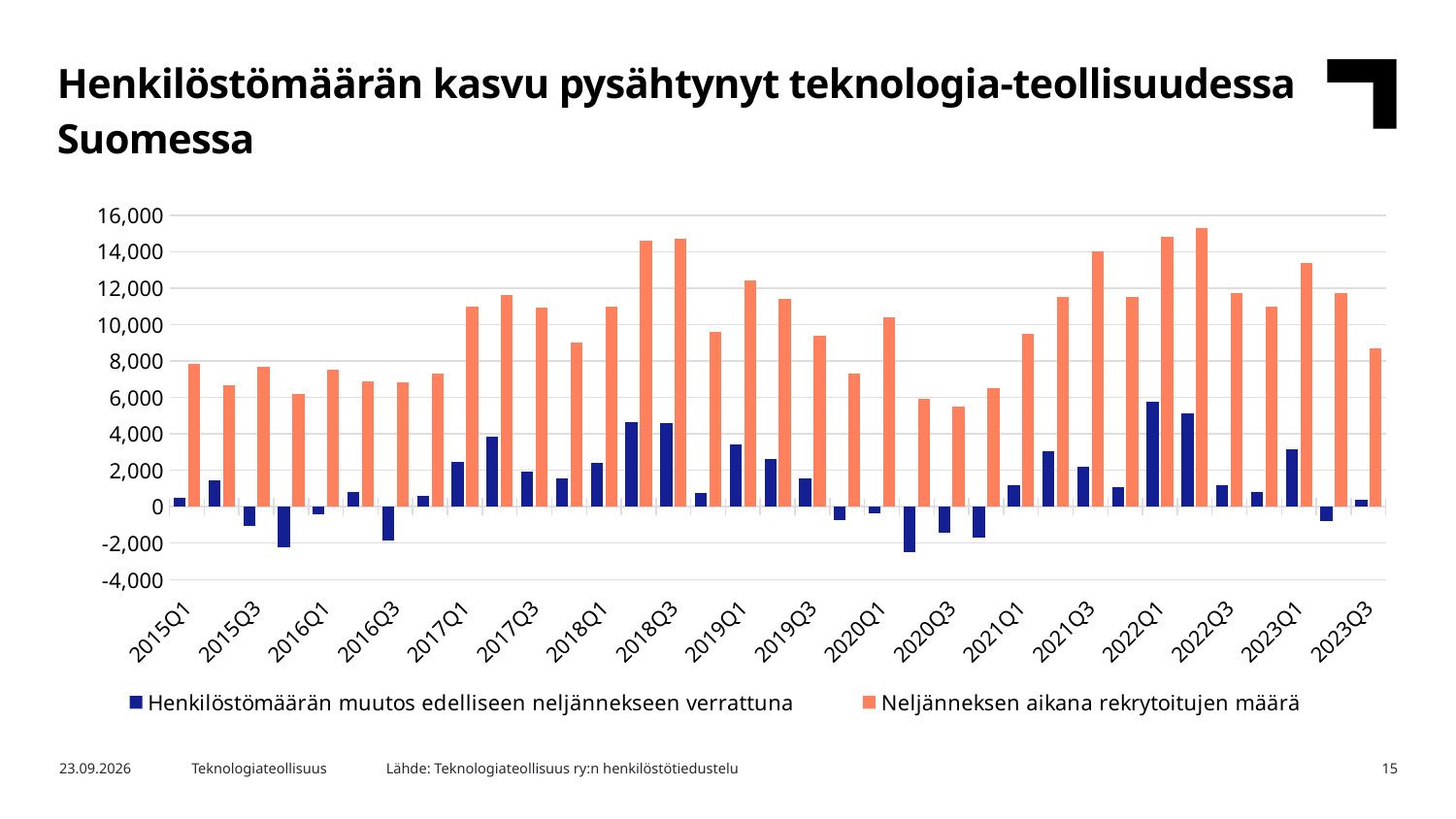
How many quarter labels are shown on the x axis? 18 Is the value of Neljänneksen aikana rekrytoitujen määrä for 2020Q3 greater or less than 6,000? less Is the value of Henkilöstömäärän muutos edelliseen neljännekseen verrattuna for 2022Q1 greater or less than 4,000? greater Which is larger for Neljänneksen aikana rekrytoitujen määrä: 2017Q1 or 2015Q1? 2017Q1 Is the value of Henkilöstömäärän muutos edelliseen neljännekseen verrattuna for 2020Q2 greater or less than -2,000? less What is the title of the slide containing the chart? Henkilöstömäärän kasvu pysähtynyt teknologia-teollisuudessa Suomessa Which series is drawn in orange? Neljänneksen aikana rekrytoitujen määrä How many series does the legend list? 2 What kind of chart is shown on the slide? Bar chart Which quarter has the highest value of Henkilöstömäärän muutos edelliseen neljännekseen verrattuna? 2022Q1